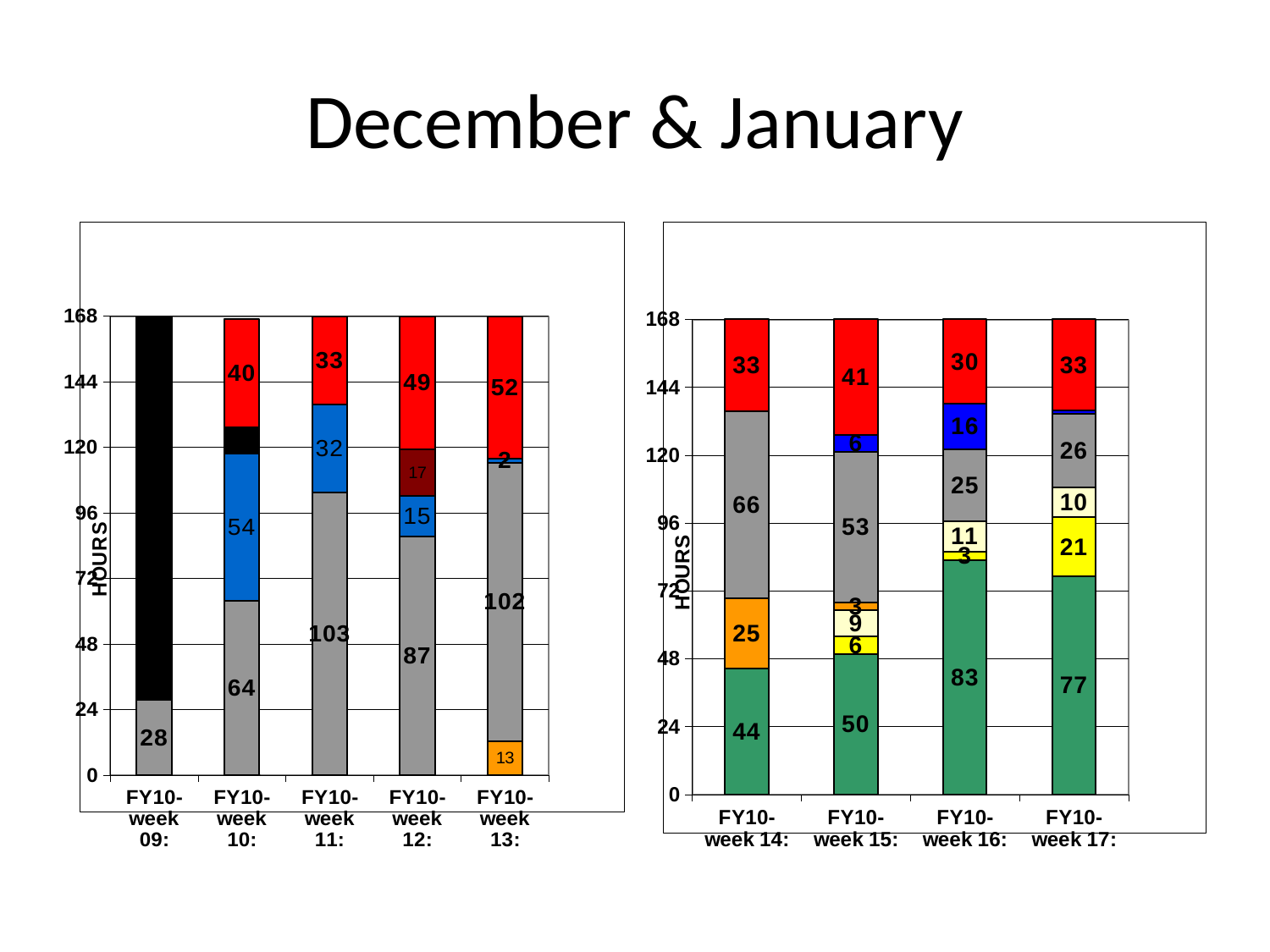
What is the y-axis label of the right chart? HOURS In the left chart, which week has the largest grey segment? FY10-week 11 How many weeks are shown on the x axis of the right chart? 4 In the left chart, what is the value of the orange segment for FY10-week 13? 13 In the left chart, which is larger: the red segment for FY10-week 12 or the red segment for FY10-week 10? FY10-week 12 In the right chart, what is the value of the green segment for FY10-week 16? 83 In the right chart, which week has the smallest green segment? FY10-week 14 In the right chart, what is the difference between the green segments for FY10-week 16 and FY10-week 17? 6 In the right chart, what is the value of the grey segment for FY10-week 14? 66 In the left chart, what is the value of the red segment for FY10-week 13? 52 What type of chart is the left chart? Stacked bar chart In the left chart, what is the value of the grey segment for FY10-week 11? 103